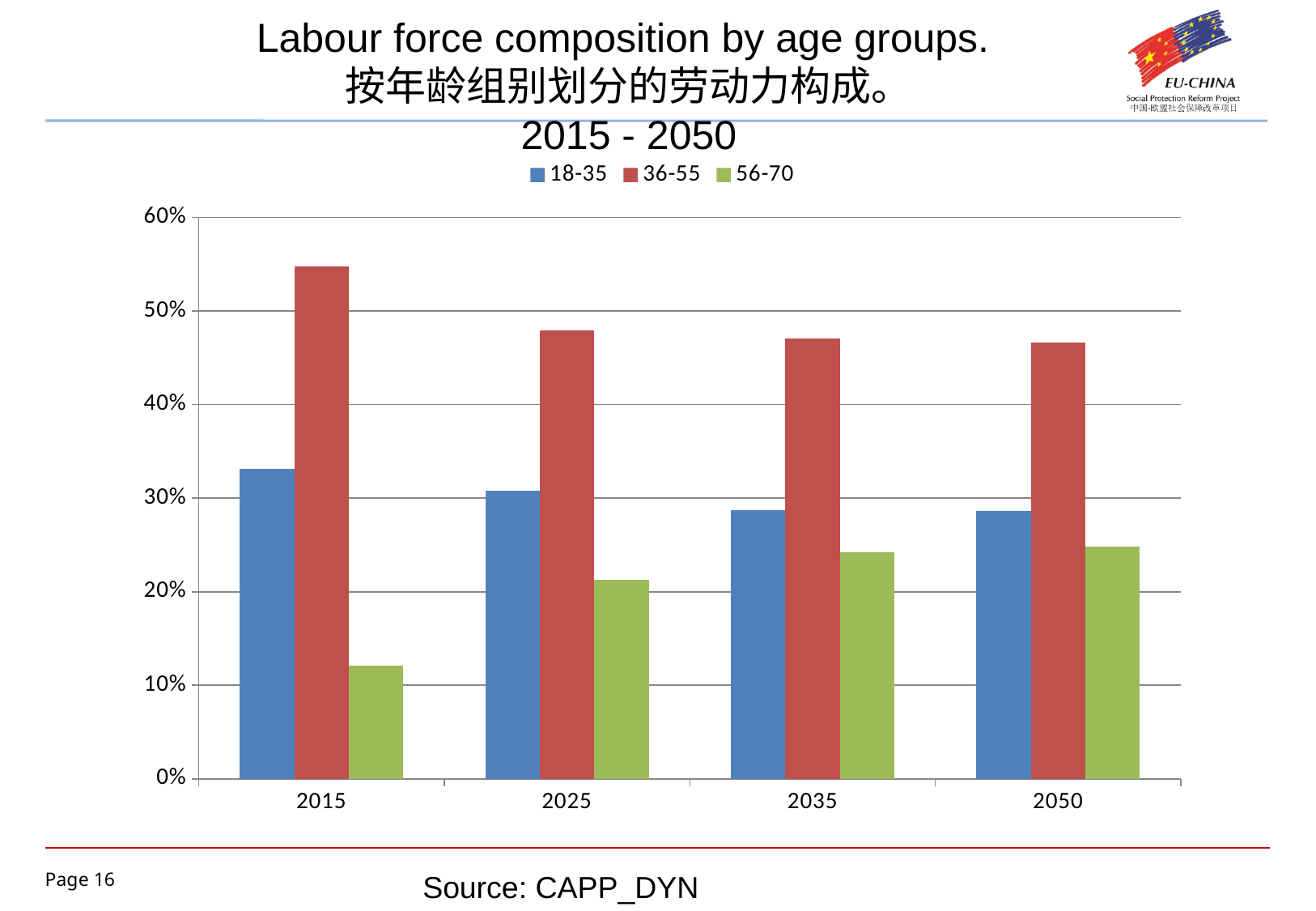
What kind of chart is shown on the slide? bar chart Which age group is shown in red in the legend? 36-55 Is the value for the 18-35 group in 2015 greater or less than 30%? greater In which year is the 36-55 group's share highest? 2015 How many series does the legend list? 3 How many years are shown on the x axis? 4 Is the value for the 36-55 group in 2015 greater or less than 50%? greater Does the share of the 56-70 group rise or fall from 2015 to 2050? rise In which year is the 56-70 group's share lowest? 2015 Is the value for the 36-55 group in 2025 greater or less than 50%? less